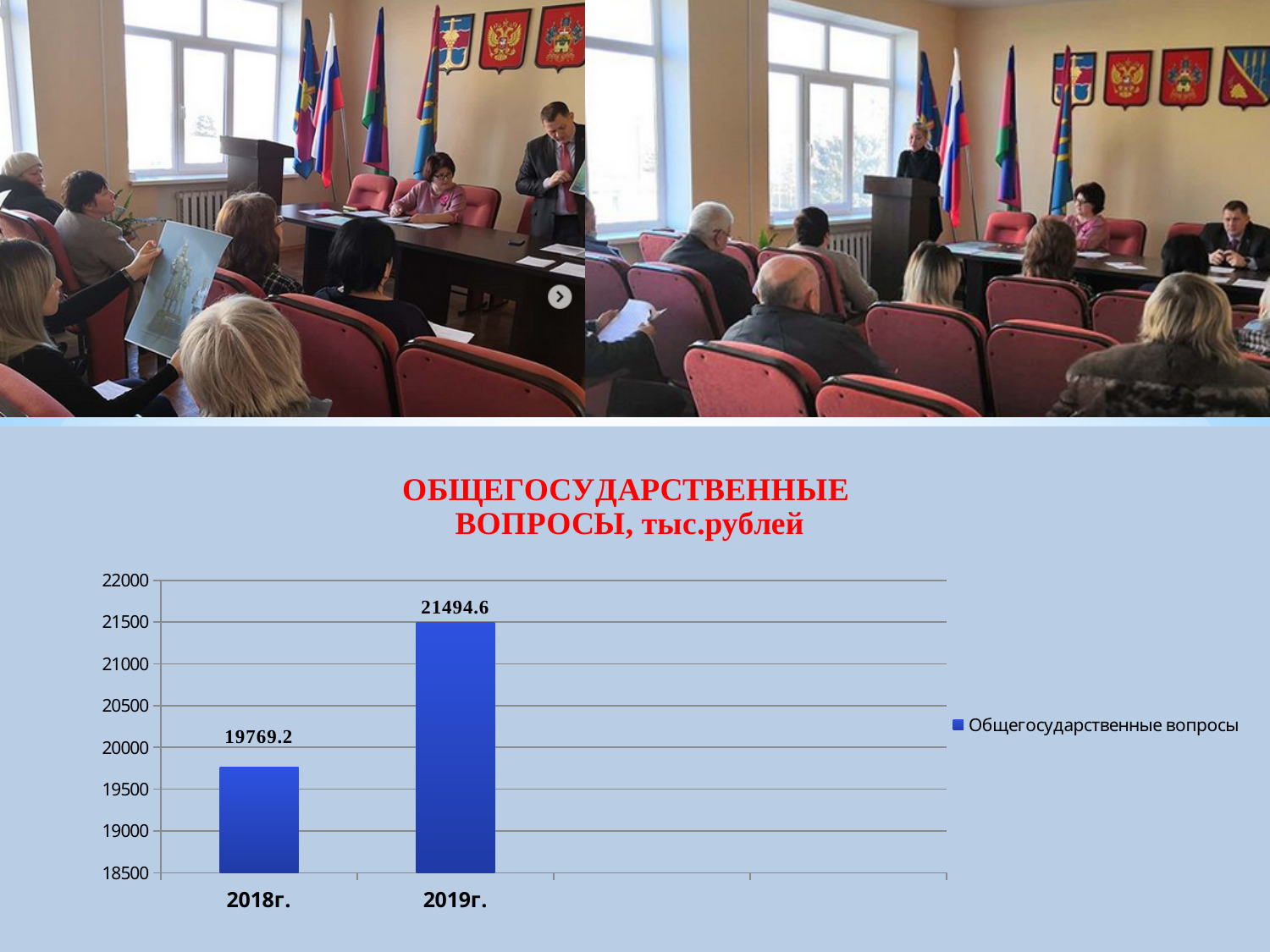
What is the difference between the values for 2019г. and 2018г.? 1725.4 Which year has the highest value? 2019г. Which is larger, the value for 2018г. or the value for 2019г.? 2019г. What is the value for 2018г.? 19769.2 How many years are shown on the chart? 2 What kind of chart is shown on the slide? bar chart Which year has the lowest value? 2018г. Is the value for 2019г. greater or less than 21000? greater Is the value for 2018г. greater or less than 20000? less Do the values rise or fall from 2018г. to 2019г.? rise How many series does the legend list? 1 What is the value for 2019г.? 21494.6